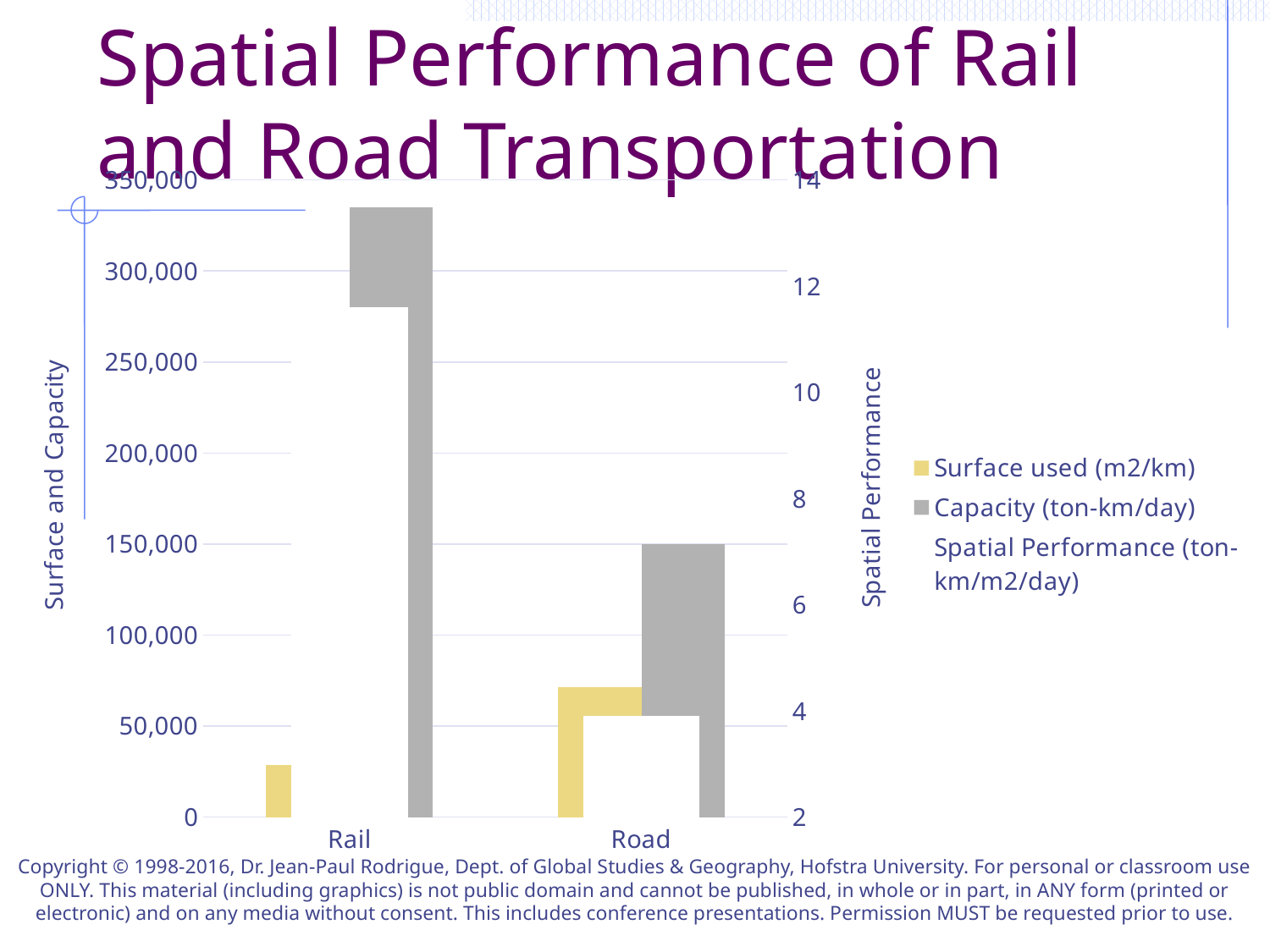
What kind of chart is shown on the slide? bar chart How many series does the legend list? 3 Is the Capacity (ton-km/day) value for Rail greater or less than 300,000? greater What is the label of the left vertical axis? Surface and Capacity Which series has the tallest bar on the chart? Capacity (ton-km/day) Is the Surface used (m2/km) value for Road greater or less than 100,000? less Which category has the higher Capacity (ton-km/day), Rail or Road? Rail How many categories are shown on the x axis? 2 What is the label of the right vertical axis? Spatial Performance Is the Surface used (m2/km) value for Rail greater or less than 50,000? less Which category has the higher Surface used (m2/km), Rail or Road? Road